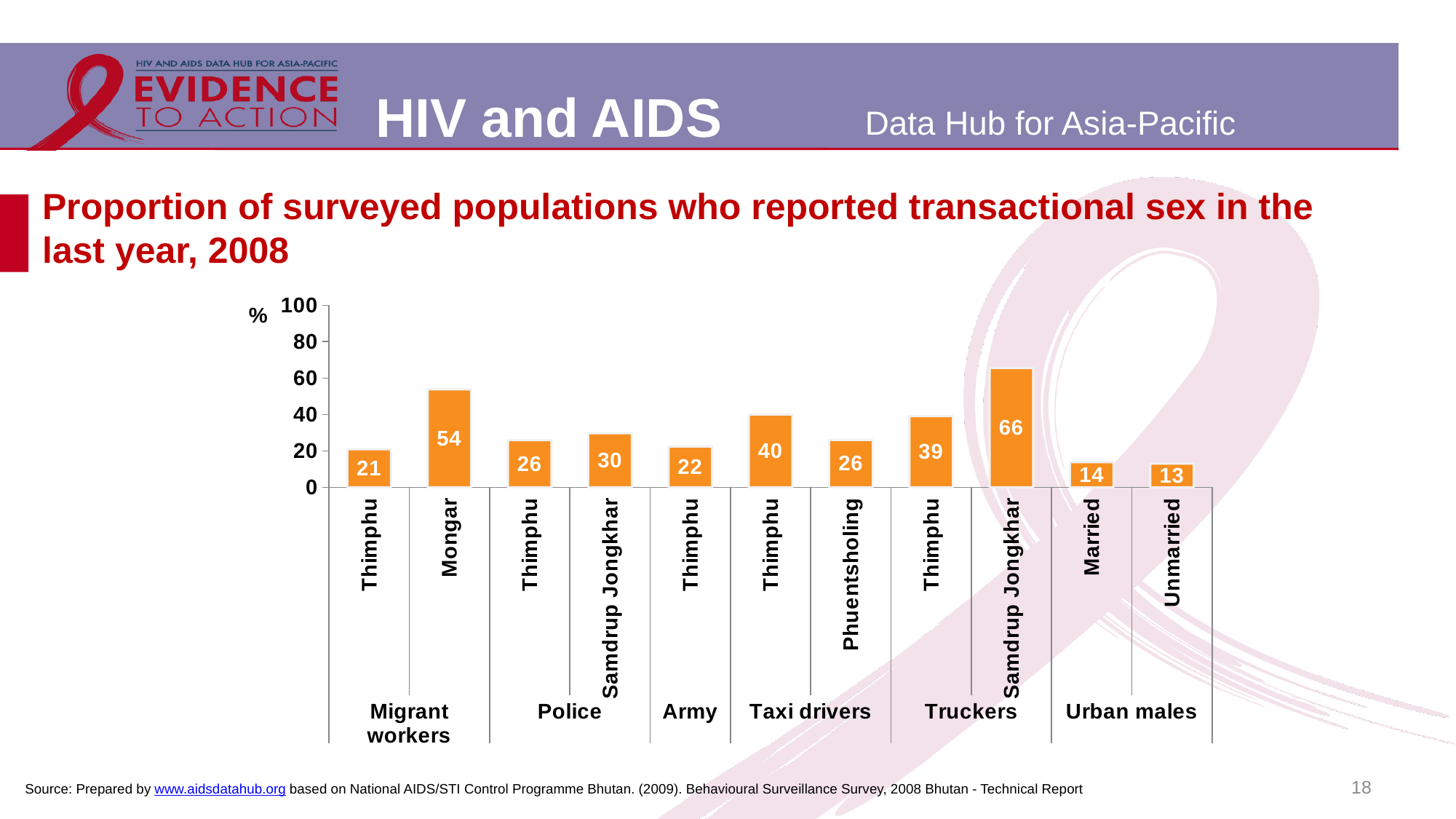
What is the value for unmarried urban males? 13 Which bar has the highest value? Samdrup Jongkhar (Truckers) Which bar has the lowest value? Unmarried (Urban males) What is the value for Samdrup Jongkhar truckers? 66 Which is larger, the value for Thimphu police or Samdrup Jongkhar police? Samdrup Jongkhar police What is the value for Mongar migrant workers? 54 What kind of chart is shown? bar chart What is the value for Thimphu taxi drivers? 40 How many bars are plotted in the chart? 11 What is the maximum value shown on the y axis? 100 Is the value for Thimphu army greater or less than 40? less What is the difference between the values for Mongar migrant workers and Thimphu migrant workers? 33